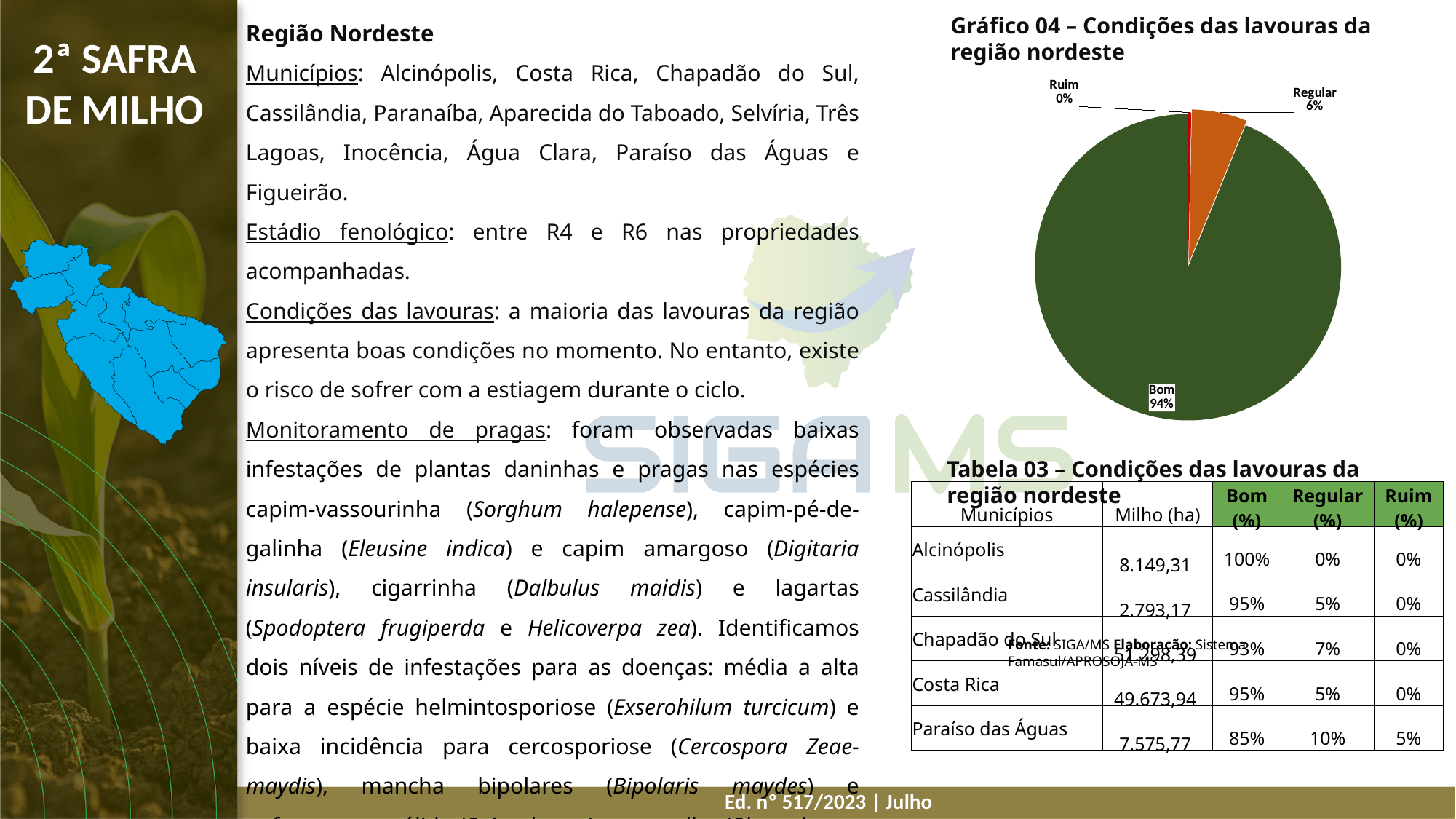
In Gráfico 04, what is the difference in percentage points between the Bom and Regular slices? 88 In Gráfico 04, which category has the largest slice? Bom In Gráfico 04, what is the combined share of the Bom and Regular slices? 100% In Gráfico 04, which slice is larger, Regular or Ruim? Regular In Gráfico 04, which category has the smallest slice? Ruim What kind of chart is Gráfico 04 – Condições das lavouras da região nordeste? pie chart In Gráfico 04, what share of the lavouras is labelled Regular? 6% In Gráfico 04, what colour is the Bom slice? dark green In Gráfico 04, what share of the lavouras is labelled Bom? 94% In Gráfico 04, what share of the lavouras is labelled Ruim? 0% What is the title of the pie chart on the slide? Gráfico 04 – Condições das lavouras da região nordeste In Gráfico 04, how many categories are shown in the pie? 3